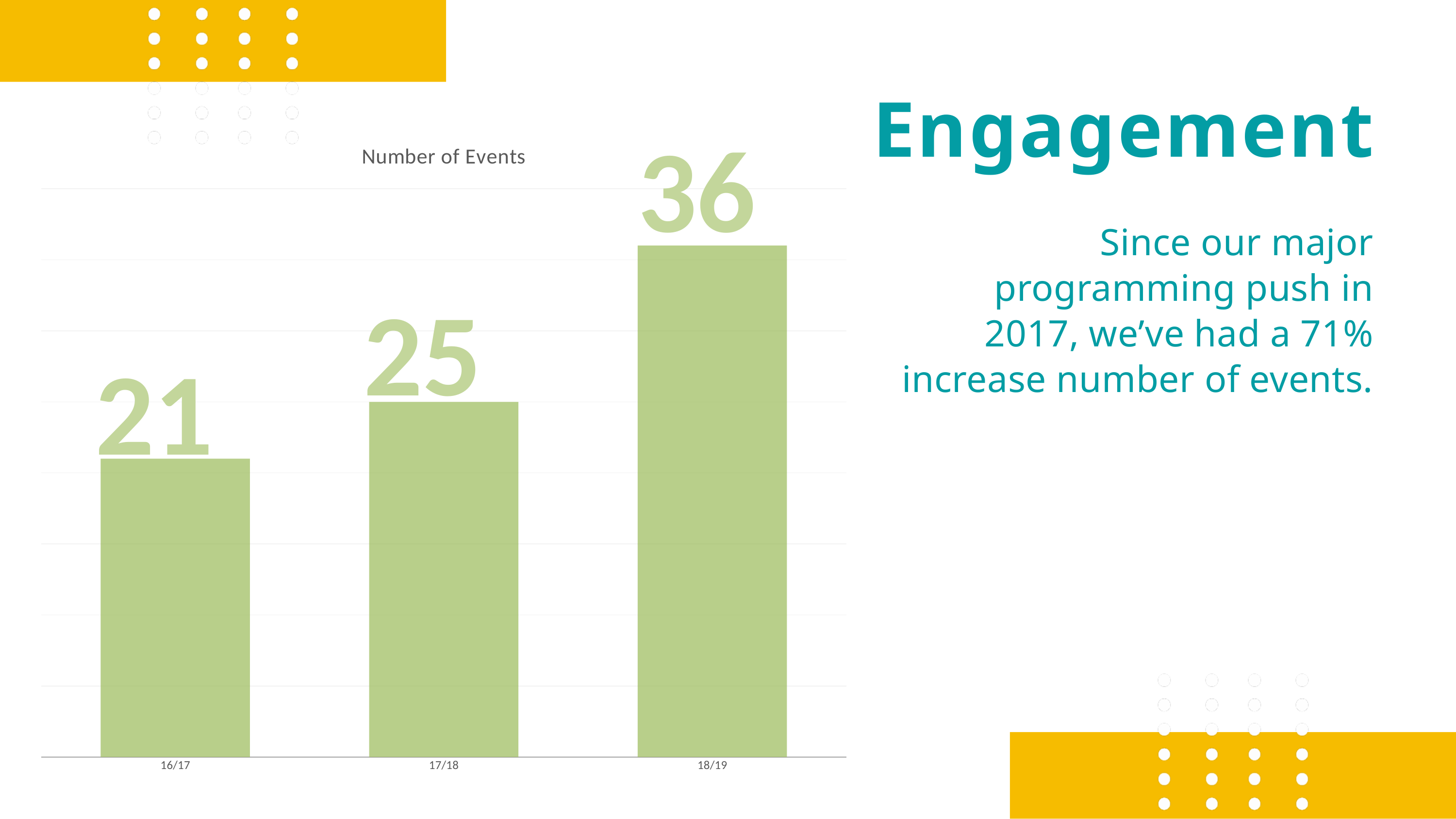
What kind of chart is shown on the slide? Bar chart Which has more events, 17/18 or 18/19? 18/19 What is the difference in number of events between 17/18 and 16/17? 4 What is the difference in number of events between 18/19 and 16/17? 15 Does the number of events rise or fall from 16/17 to 18/19? Rise What is the number of events for 17/18? 25 What is the number of events for 18/19? 36 What is the number of events for 16/17? 21 What is the title of the chart? Number of Events Which year has the highest number of events? 18/19 How many years are shown on the chart? 3 Which year has the lowest number of events? 16/17